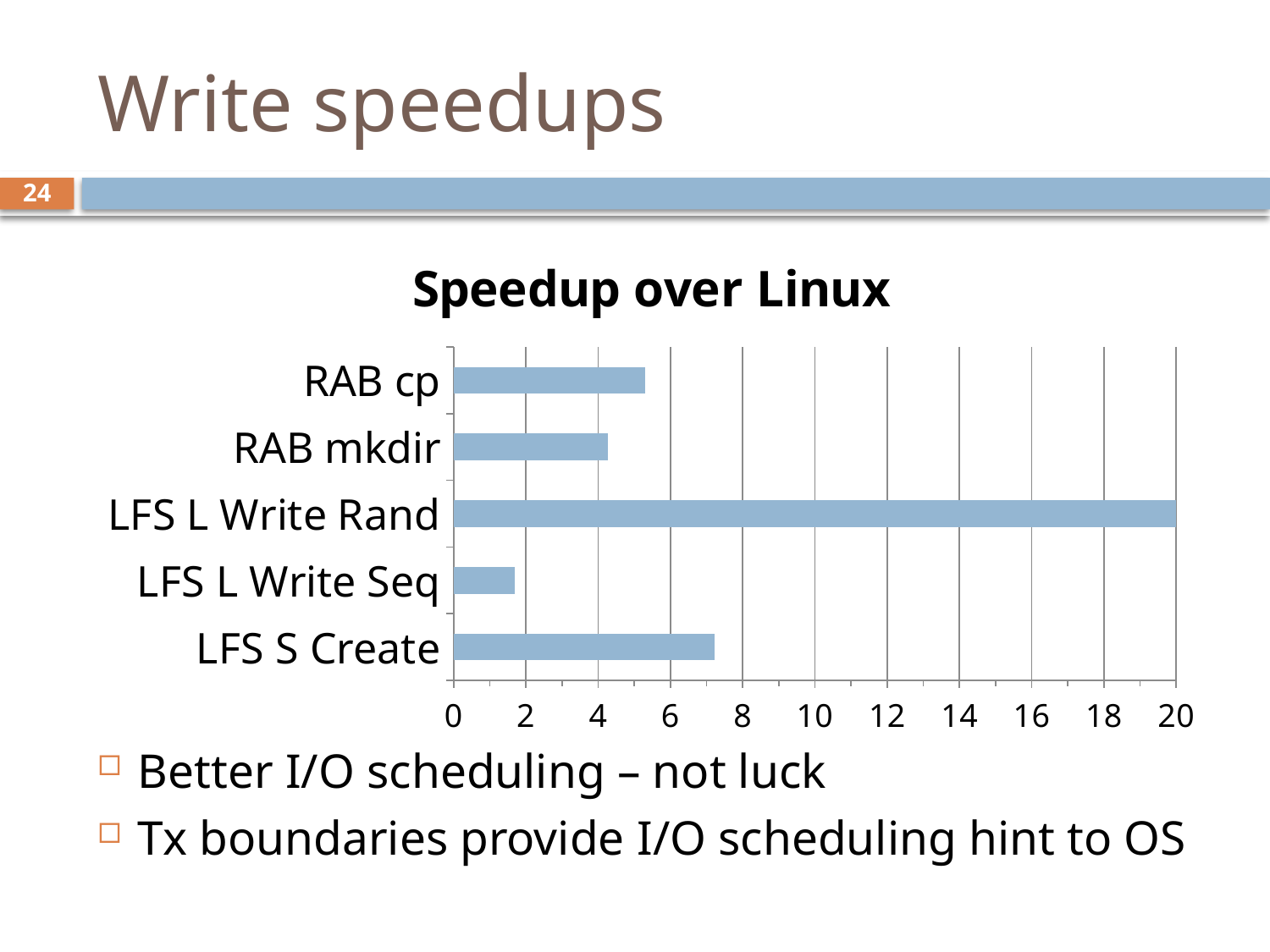
Which category has the highest speedup over Linux? LFS L Write Rand Is the value for LFS S Create greater or less than 6? greater Which is larger, the value for LFS S Create or the value for RAB cp? LFS S Create What is the title of the chart? Speedup over Linux What kind of chart is shown on the slide? bar chart How many categories are plotted in the chart? 5 Is the value for RAB mkdir greater or less than 6? less Is the value for LFS L Write Rand greater or less than 18? greater Which is larger, the value for RAB mkdir or the value for LFS L Write Seq? RAB mkdir Which category has the lowest speedup over Linux? LFS L Write Seq